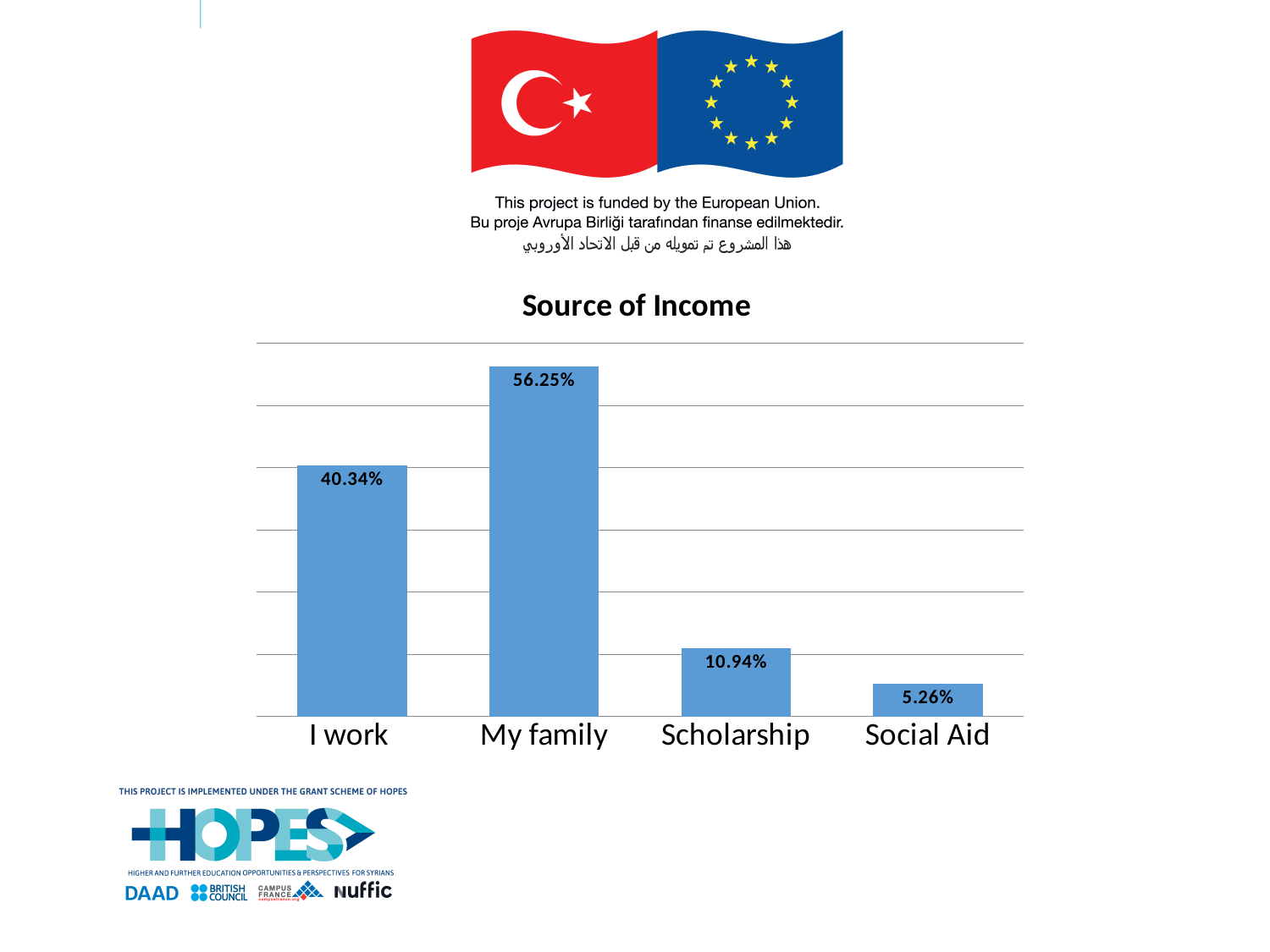
Which source of income has the highest value? My family What is the difference between the values for 'Scholarship' and 'Social Aid'? 5.68% How many categories are shown in the Source of Income chart? 4 Which source of income has the lowest value? Social Aid Which is larger, the value for 'I work' or the value for 'Scholarship'? I work What kind of chart is shown on the slide? Bar chart What is the value for 'I work' in the Source of Income chart? 40.34% What is the value for 'Scholarship' in the Source of Income chart? 10.94% What is the value for 'My family' in the Source of Income chart? 56.25% What is the difference between the values for 'My family' and 'I work'? 15.91% What is the title of the chart on the slide? Source of Income What is the value for 'Social Aid' in the Source of Income chart? 5.26%